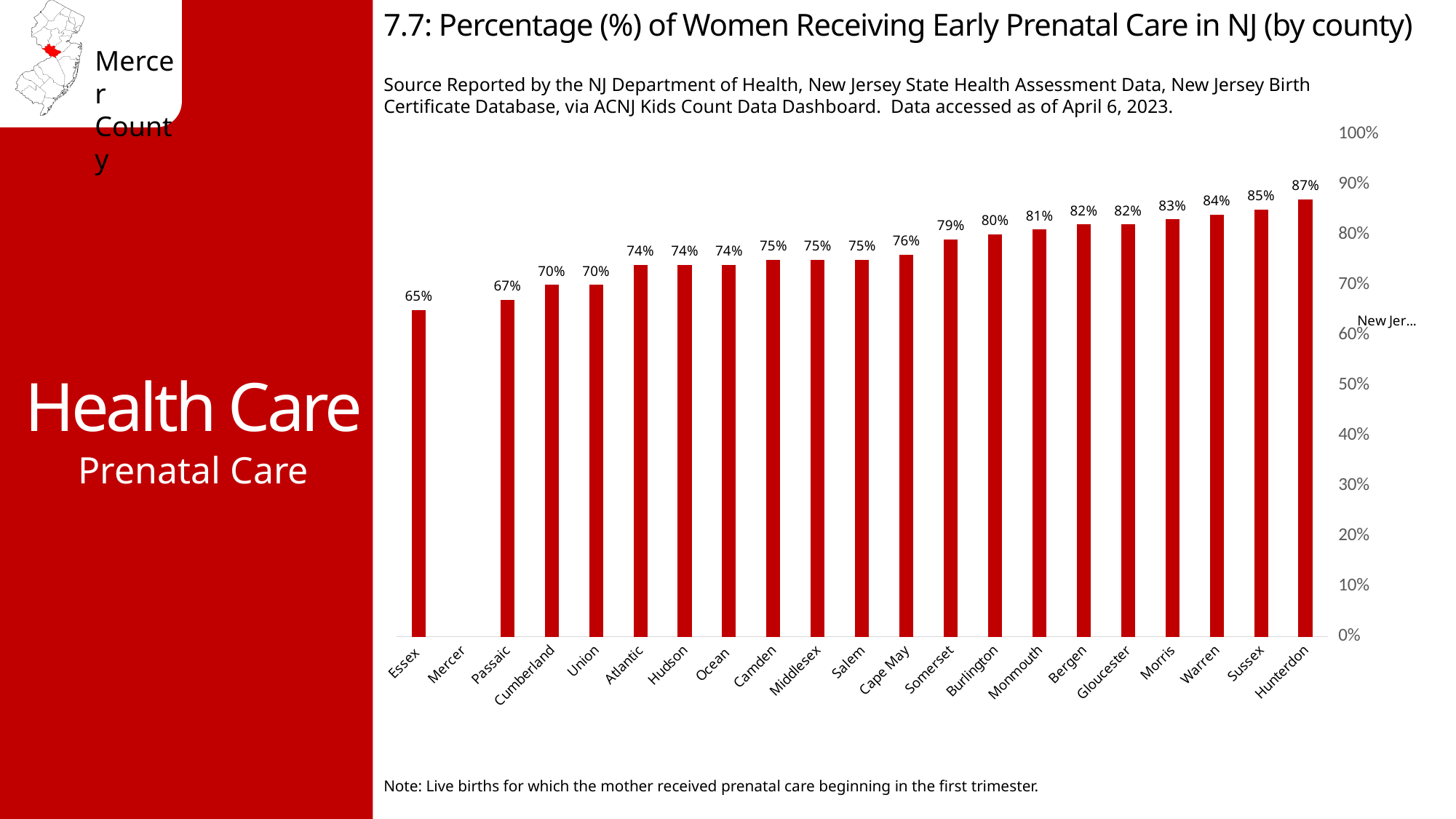
What is the difference between the values for Hunterdon and Essex? 22 percentage points What is the value for Essex? 65% What is the value for Somerset? 79% Is the value for Somerset greater or less than 80%? less How many counties are labelled on the x axis? 21 What is the value for Cape May? 76% Which county has the highest value? Hunterdon Do the values generally rise or fall from left to right along the x axis? Rise What kind of chart is shown? Bar chart Which county has the lowest labelled value? Essex Which is larger, the value for Passaic or the value for Burlington? Burlington What is the value for Hunterdon? 87%